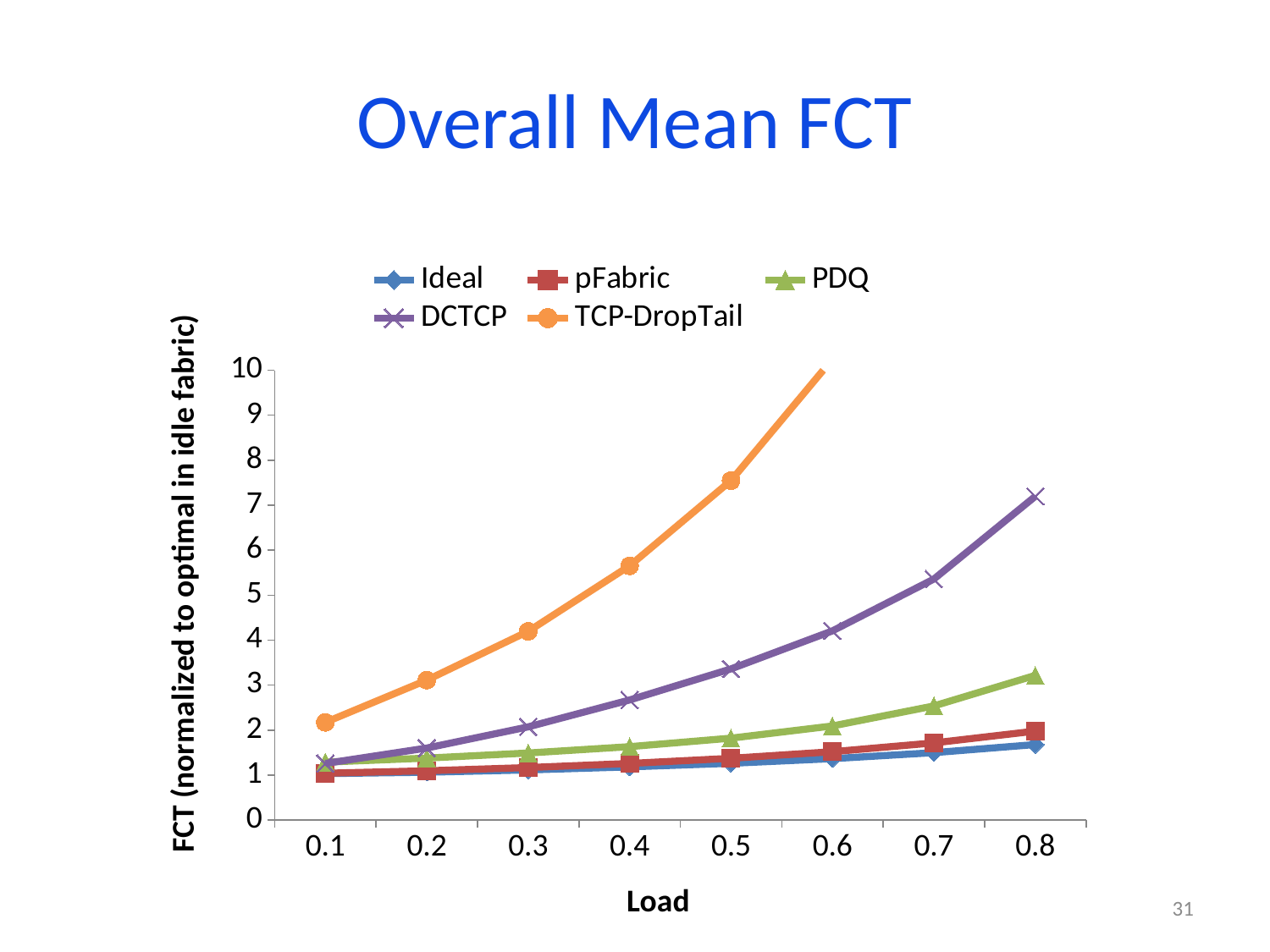
At load 0.6, which is larger, DCTCP or PDQ? DCTCP How many series does the legend list? 5 Which series has the highest FCT at load 0.8? TCP-DropTail Is the value for TCP-DropTail at load 0.5 greater or less than 6? greater What is the title of the chart? Overall Mean FCT Which series has the highest FCT at load 0.5? TCP-DropTail Does the FCT for TCP-DropTail rise or fall as load increases? rise Is the value for DCTCP at load 0.5 greater or less than 4? less How many load values are marked on the x axis? 8 Is the value for PDQ at load 0.8 greater or less than 4? less What kind of chart is shown on the slide? line chart